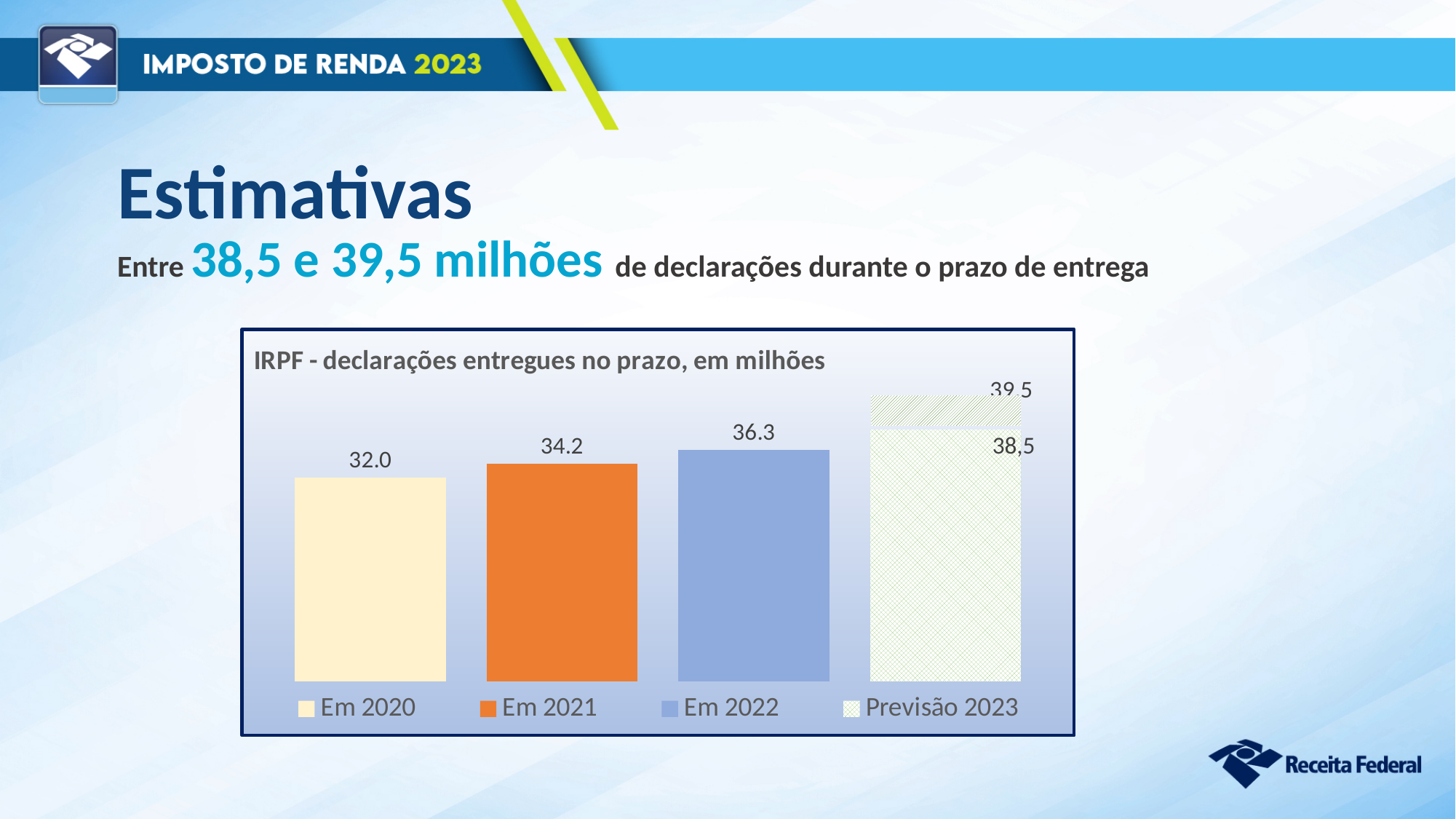
What is the value shown for Em 2022? 36.3 What kind of chart is shown on the slide? Bar chart Do the values rise or fall from Em 2020 to Previsão 2023? Rise Which bar is the highest in the chart? Previsão 2023 What is the difference between the values for Em 2022 and Em 2021? 2.1 How many bars are plotted in the chart? 4 What is the difference between the values for Em 2022 and Em 2020? 4.3 What is the value shown for Em 2021? 34.2 What range of values is labelled on the Previsão 2023 bar? 38,5 to 39,5 Which is larger, the value for Em 2021 or the value for Em 2020? Em 2021 What is the value shown for Em 2020? 32.0 Which bar is the lowest in the chart? Em 2020